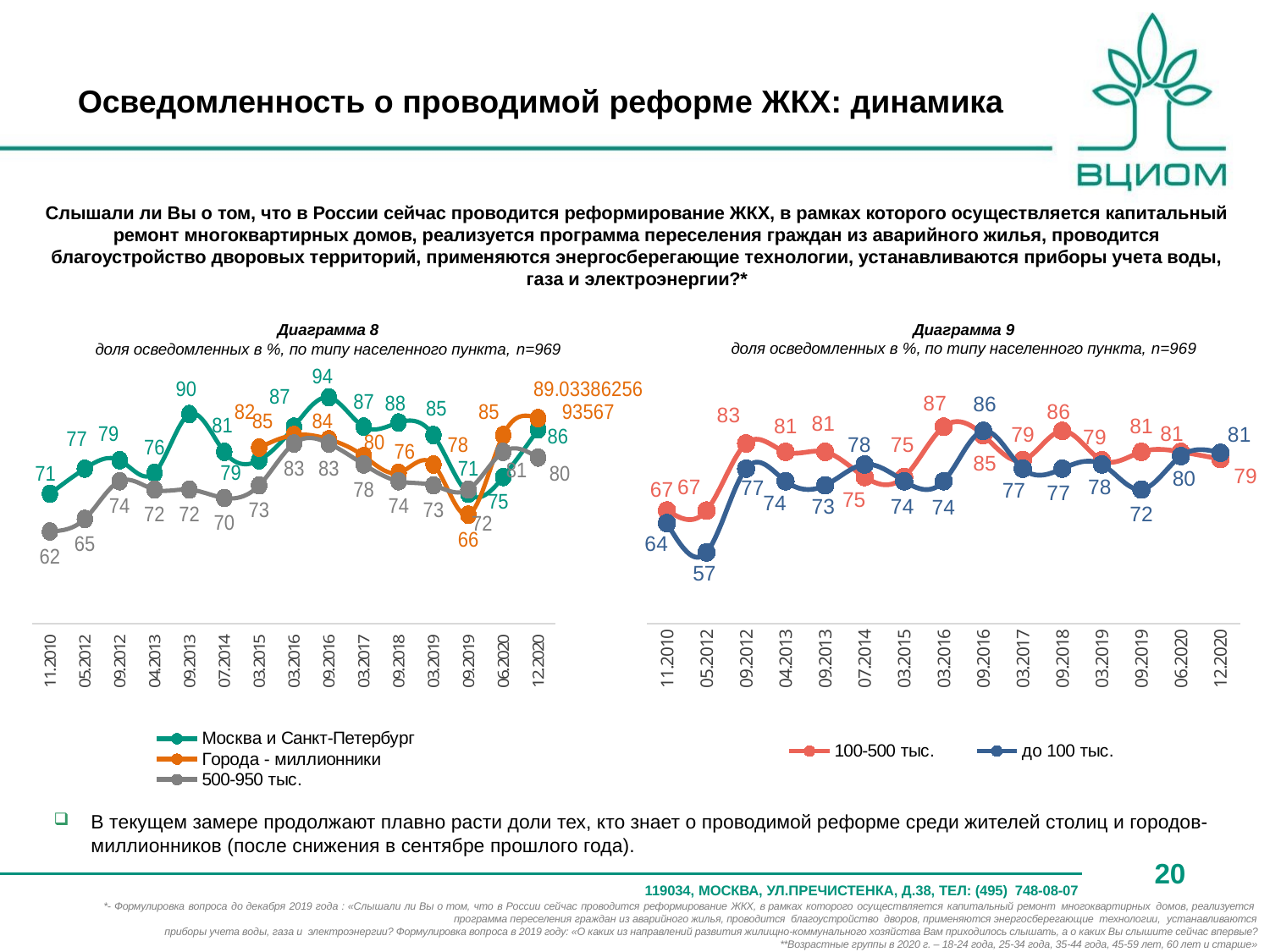
In Диаграмма 9, what is the difference between 100-500 тыс. and до 100 тыс. in 05.2012? 10 How many time points are shown on the x axis of Диаграмма 9? 15 In Диаграмма 8, what is the difference between Москва и Санкт-Петербург and 500-950 тыс. in 11.2010? 9 In Диаграмма 9, in which period does the 100-500 тыс. series reach its highest value? 03.2016 How many series does the legend of Диаграмма 9 list? 2 In Диаграмма 8, what is the value for Города - миллионники in 09.2019? 66 In Диаграмма 9, in which period does the до 100 тыс. series reach its lowest value? 05.2012 What kind of chart is Диаграмма 8? Line chart How many series does the legend of Диаграмма 8 list? 3 In Диаграмма 8, what is the value for Москва и Санкт-Петербург in 09.2016? 94 In Диаграмма 9, what is the value for до 100 тыс. in 05.2012? 57 In Диаграмма 8, what is the value for 500-950 тыс. in 11.2010? 62